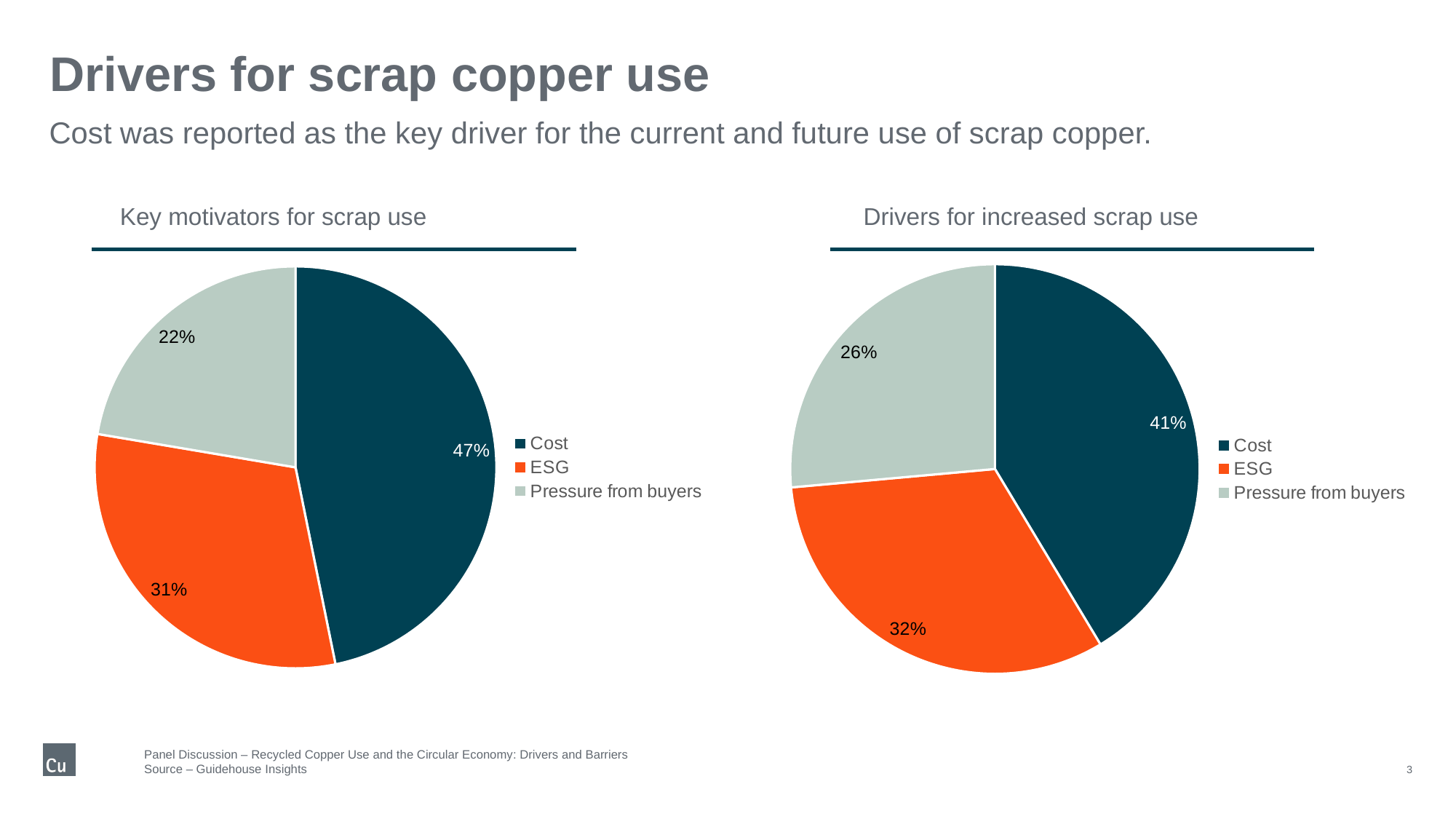
In the 'Drivers for increased scrap use' chart, what share does Pressure from buyers have? 26% In the 'Key motivators for scrap use' chart, what share does Cost have? 47% What kind of chart is 'Key motivators for scrap use'? Pie chart In the 'Drivers for increased scrap use' chart, what is the difference between the ESG and Pressure from buyers shares? 6% In the 'Drivers for increased scrap use' chart, which category has the smallest slice? Pressure from buyers Is the share for Cost larger in the 'Key motivators for scrap use' chart or in the 'Drivers for increased scrap use' chart? Key motivators for scrap use In the 'Drivers for increased scrap use' chart, what share does Cost have? 41% How many slices does the 'Drivers for increased scrap use' chart have? 3 In the 'Key motivators for scrap use' chart, what is the difference between the Cost and ESG shares? 16% What colour is the ESG slice in the 'Key motivators for scrap use' chart? Orange In the 'Key motivators for scrap use' chart, which category has the largest slice? Cost In the 'Key motivators for scrap use' chart, what share does ESG have? 31%